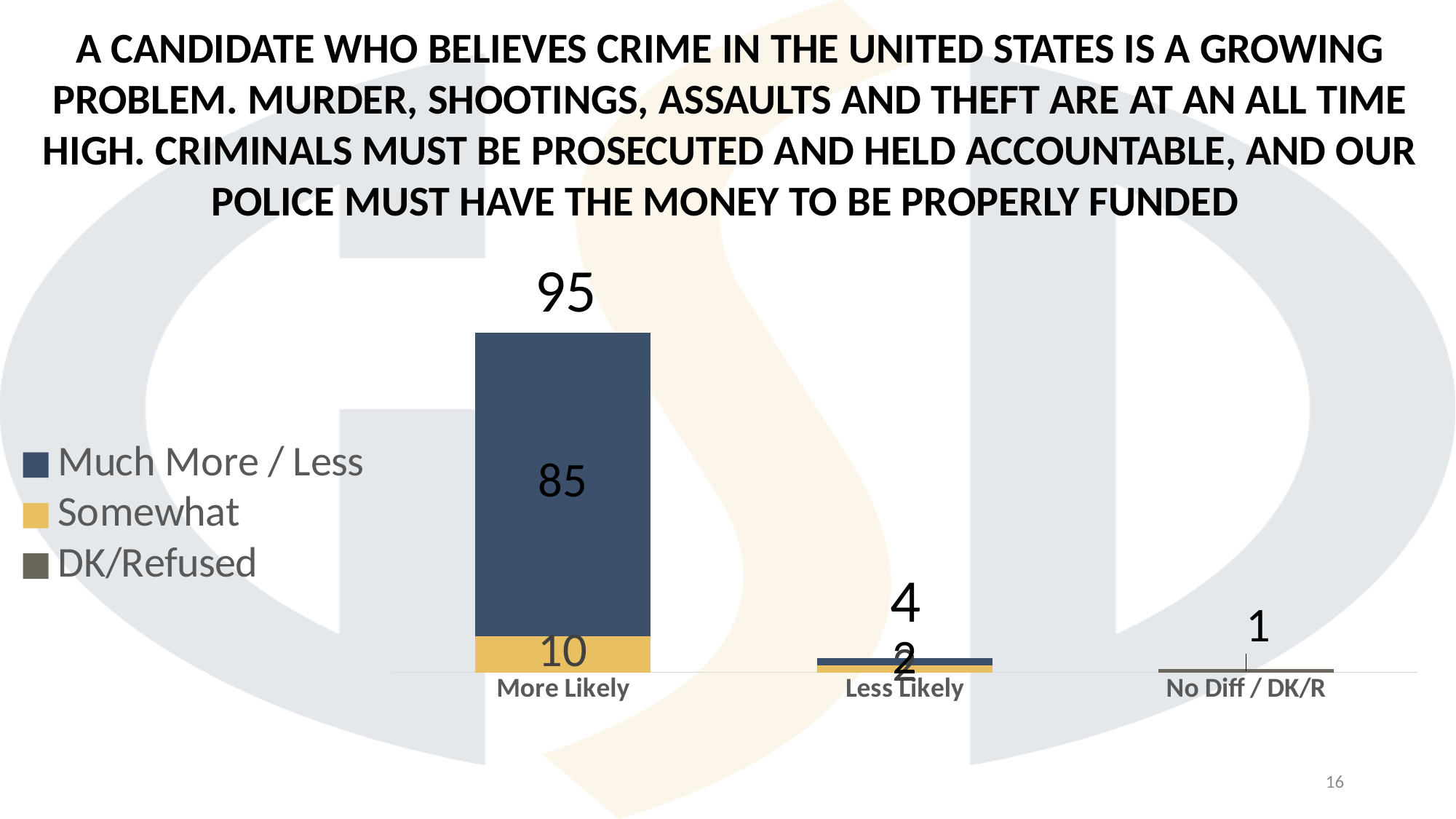
How many categories are shown on the x axis? 3 What is the Much More / Less value for the More Likely category? 85 What kind of chart is shown on the slide? Stacked bar chart What value is shown for the No Diff / DK/R category? 1 Which is larger, the Less Likely total or the No Diff / DK/R value? Less Likely What is the total value shown above the Less Likely bar? 4 What is the Somewhat value for the More Likely category? 10 Which category has the highest total? More Likely What is the total value shown above the More Likely bar? 95 How many series does the legend list? 3 What is the difference between the More Likely total and the Less Likely total? 91 Which category has the lowest total? No Diff / DK/R